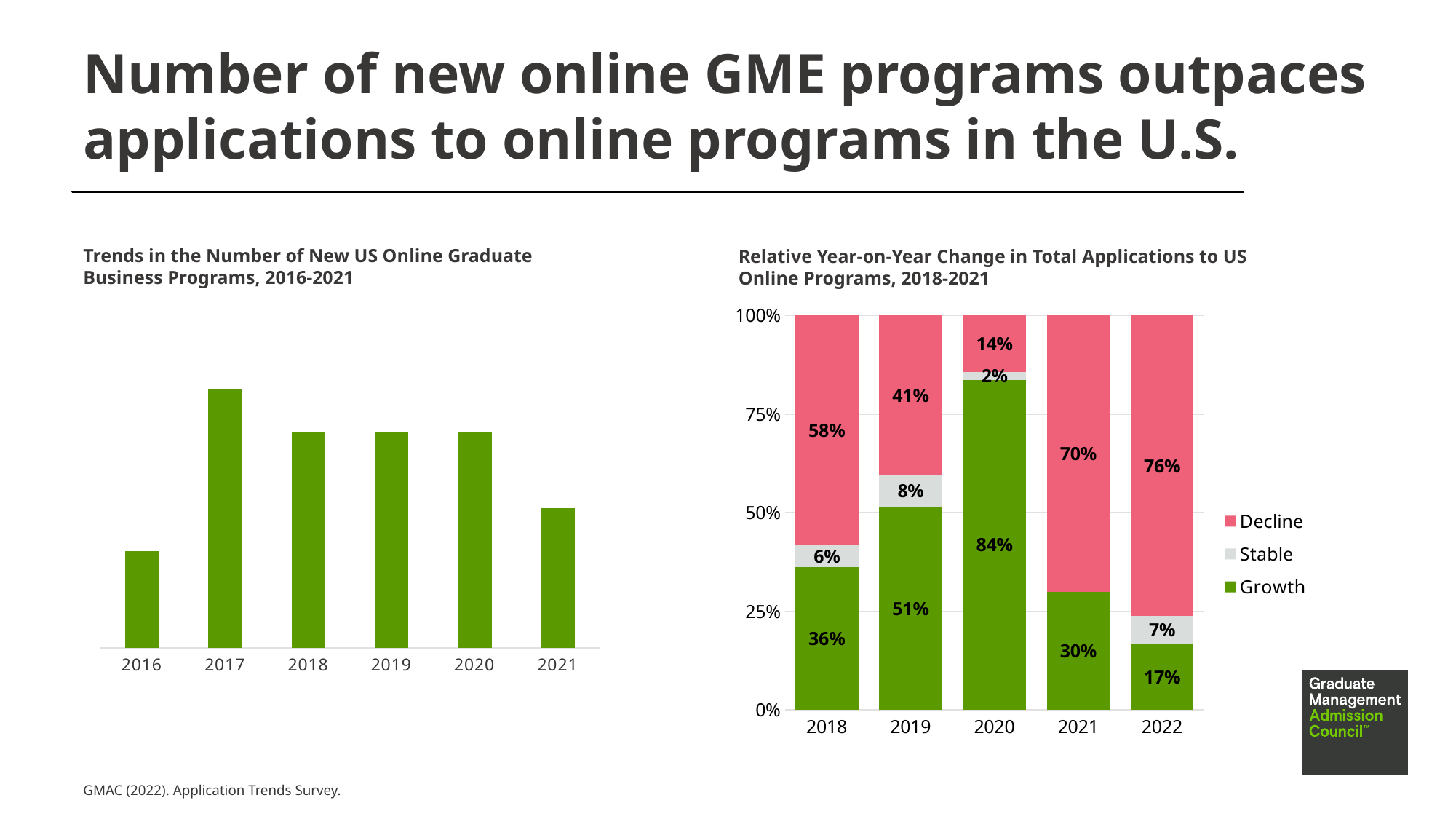
In the left chart (Trends in the Number of New US Online Graduate Business Programs), which year has the highest number of new programs? 2017 In the right chart (Relative Year-on-Year Change in Total Applications to US Online Programs), which colour represents Decline? pink In the right chart (Relative Year-on-Year Change in Total Applications to US Online Programs), which year has the highest Growth share? 2020 In the left chart (Trends in the Number of New US Online Graduate Business Programs), how many years are shown on the x axis? 6 What kind of chart is the left chart (Trends in the Number of New US Online Graduate Business Programs)? bar chart In the right chart (Relative Year-on-Year Change in Total Applications to US Online Programs), what is the Decline share for 2022? 76% In the left chart (Trends in the Number of New US Online Graduate Business Programs), which year has the lowest number of new programs? 2016 In the right chart (Relative Year-on-Year Change in Total Applications to US Online Programs), what is the difference between the Decline share in 2022 and the Decline share in 2018? 18% In the right chart (Relative Year-on-Year Change in Total Applications to US Online Programs), what is the Growth share for 2020? 84% How many series does the legend of the right chart (Relative Year-on-Year Change in Total Applications to US Online Programs) list? 3 In the right chart (Relative Year-on-Year Change in Total Applications to US Online Programs), what is the Stable share for 2019? 8% In the left chart (Trends in the Number of New US Online Graduate Business Programs), is the bar for 2021 taller or shorter than the bar for 2018? shorter